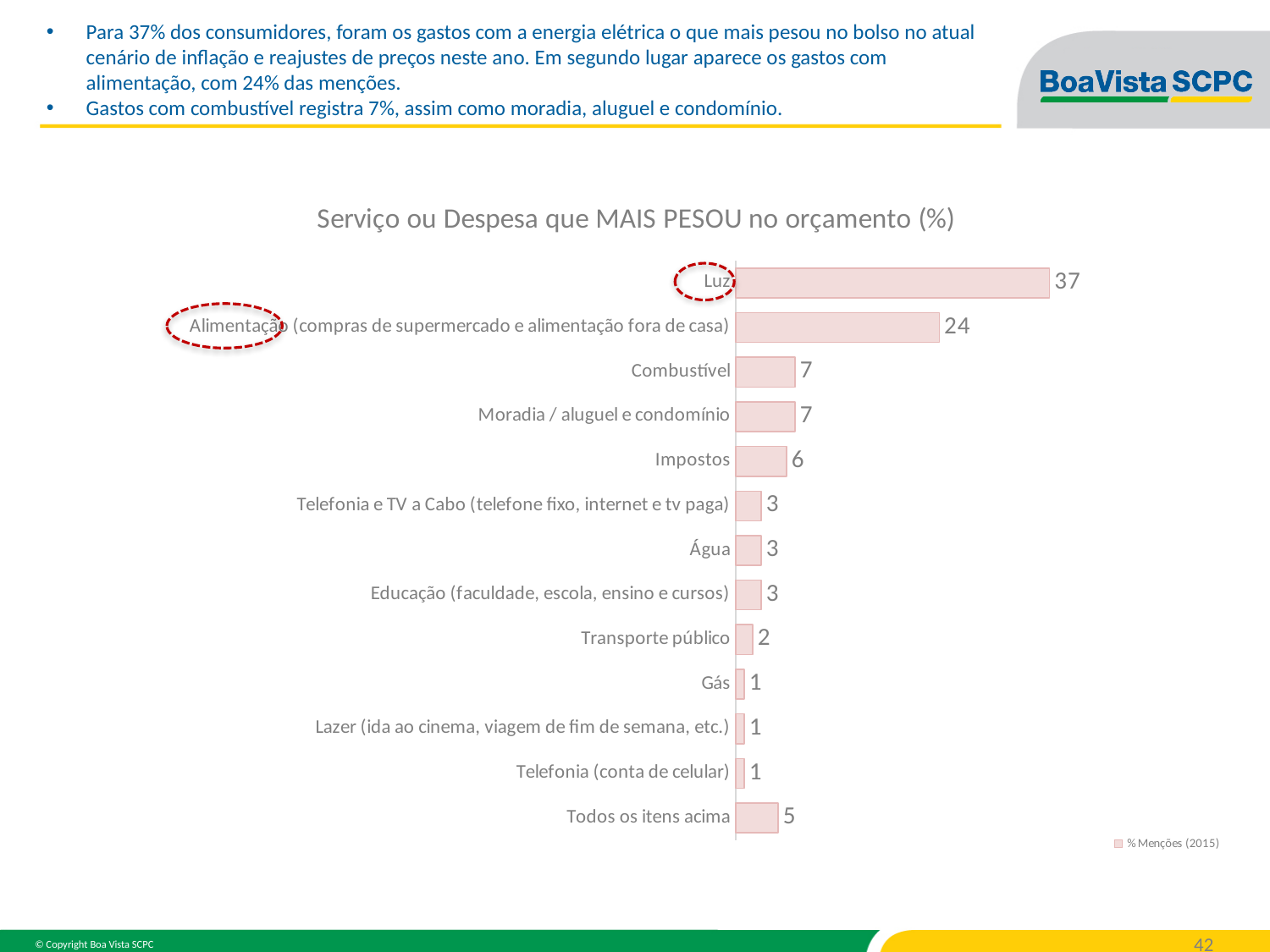
How many series does the legend list? 1 Which category has the highest value? Luz What is the difference between the values for Combustível and Transporte público? 5 What is the value for Alimentação (compras de supermercado e alimentação fora de casa)? 24 What is the value for Impostos? 6 What kind of chart is shown on the slide? Bar chart Which is larger, the value for Impostos or the value for Água? Impostos What is the title of the chart? Serviço ou Despesa que MAIS PESOU no orçamento (%) What is the value for Luz? 37 How many categories are shown in the chart? 13 What is the difference between the values for Luz and Alimentação? 13 What is the value for Todos os itens acima? 5